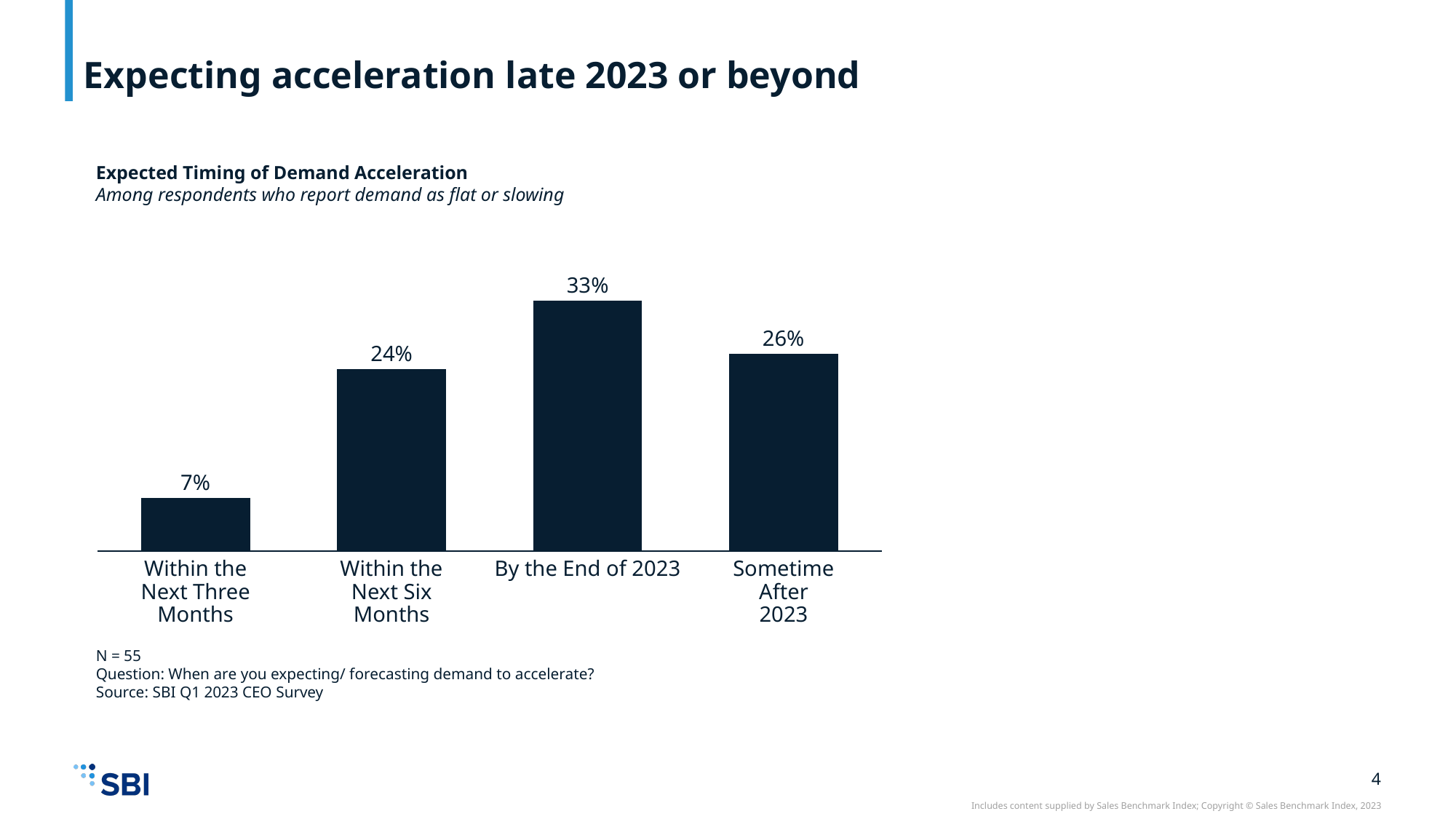
What is the sample size (N) noted below the chart? N = 55 What percentage of respondents expect demand to accelerate by the end of 2023? 33% What percentage of respondents expect demand to accelerate within the next six months? 24% What percentage of respondents expect demand to accelerate within the next three months? 7% What is the difference in percentage points between 'By the End of 2023' and 'Within the Next Six Months'? 9 percentage points What type of chart is used on this slide? Bar chart What percentage of respondents expect demand to accelerate sometime after 2023? 26% What is the title of the chart? Expected Timing of Demand Acceleration Which timing category has the lowest percentage of respondents? Within the Next Three Months Which timing category has the highest percentage of respondents? By the End of 2023 Which is larger: the value for 'Sometime After 2023' or the value for 'Within the Next Six Months'? Sometime After 2023 How many timing categories are shown in the chart? 4